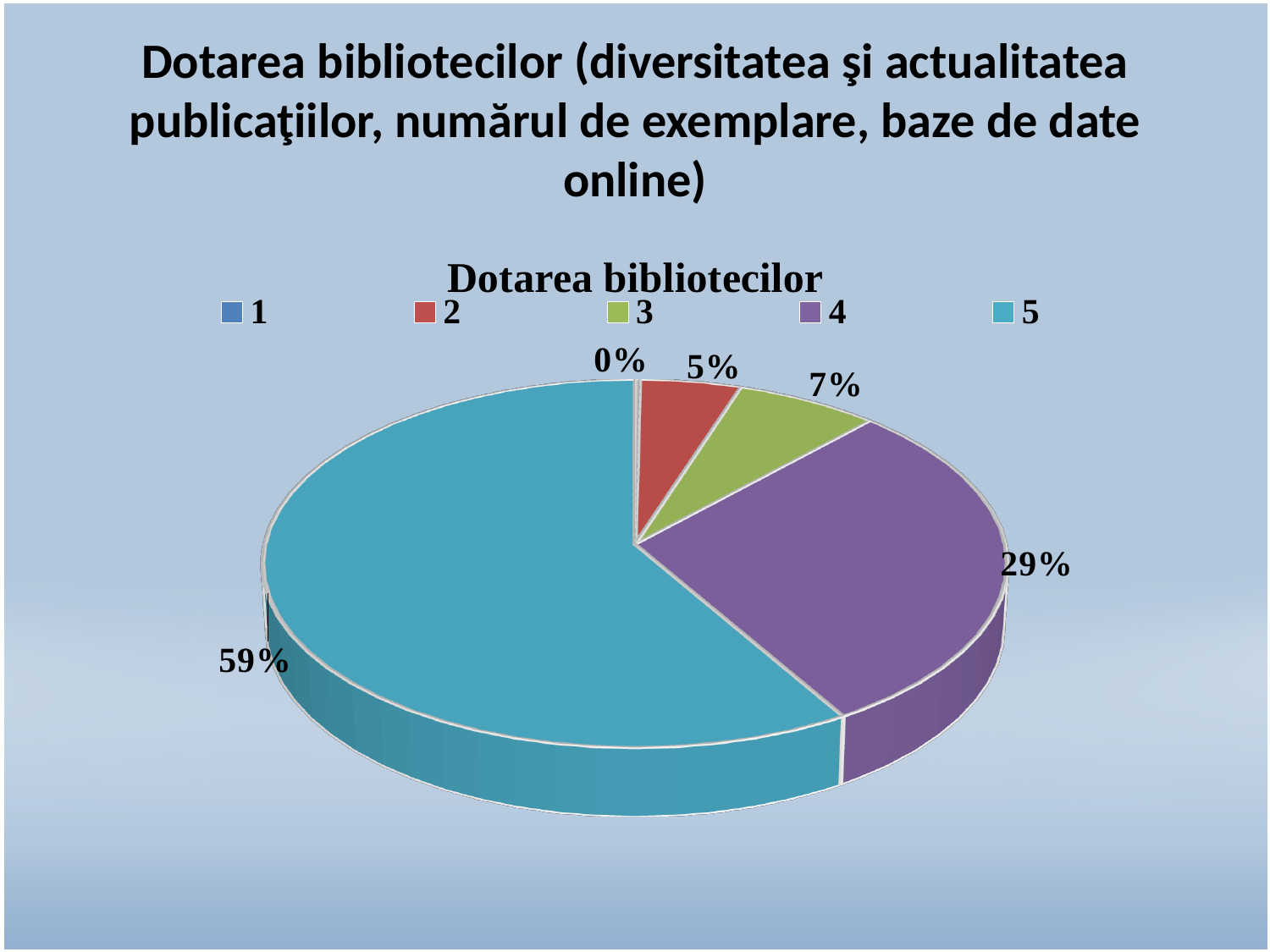
What share of the pie does category 2 have? 5% Which category has the largest share of the pie? 5 What kind of chart is shown on the slide? pie chart What share of the pie does category 4 have? 29% How many categories does the legend list? 5 Which category has the smallest share of the pie? 1 Which has a larger share, category 3 or category 2? 3 What share of the pie does category 3 have? 7% What is the chart's title? Dotarea bibliotecilor What is the difference in percentage points between category 5 and category 4? 30